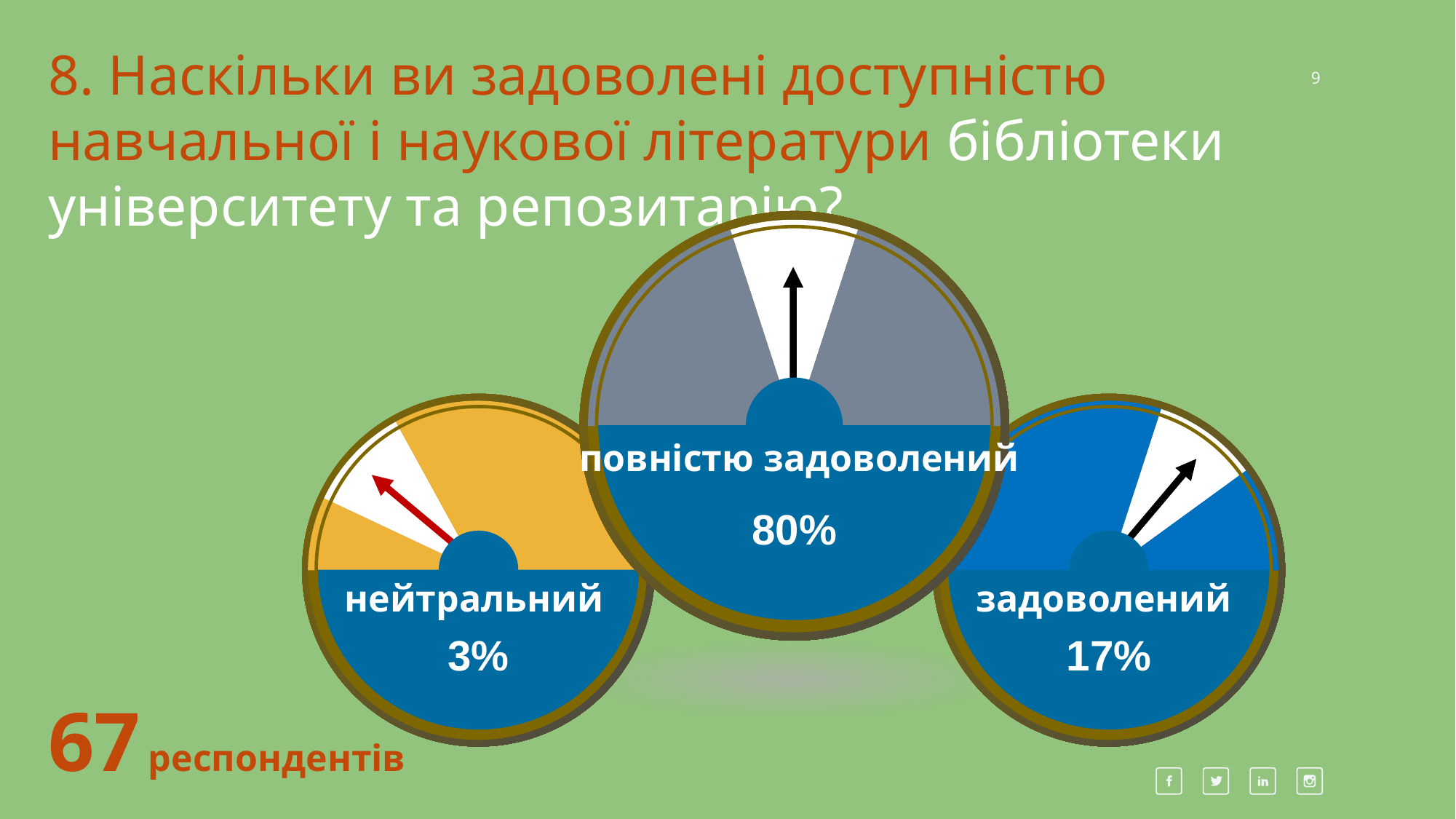
Which response category has the lowest percentage? нейтральний What percentage of respondents answered "задоволений"? 17% What is the difference in percentage points between "повністю задоволений" and "задоволений"? 63 What is the total of the three percentages shown on the gauges? 100% What percentage of respondents answered "повністю задоволений"? 80% How many response categories are shown on the slide? 3 What is the difference in percentage points between "задоволений" and "нейтральний"? 14 What percentage of respondents answered "нейтральний"? 3% Which response category has the highest percentage? повністю задоволений How many respondents took part in the survey, according to the slide? 67 Which is larger, the percentage for "задоволений" or for "нейтральний"? задоволений What kind of chart is used to show each response category? gauge chart